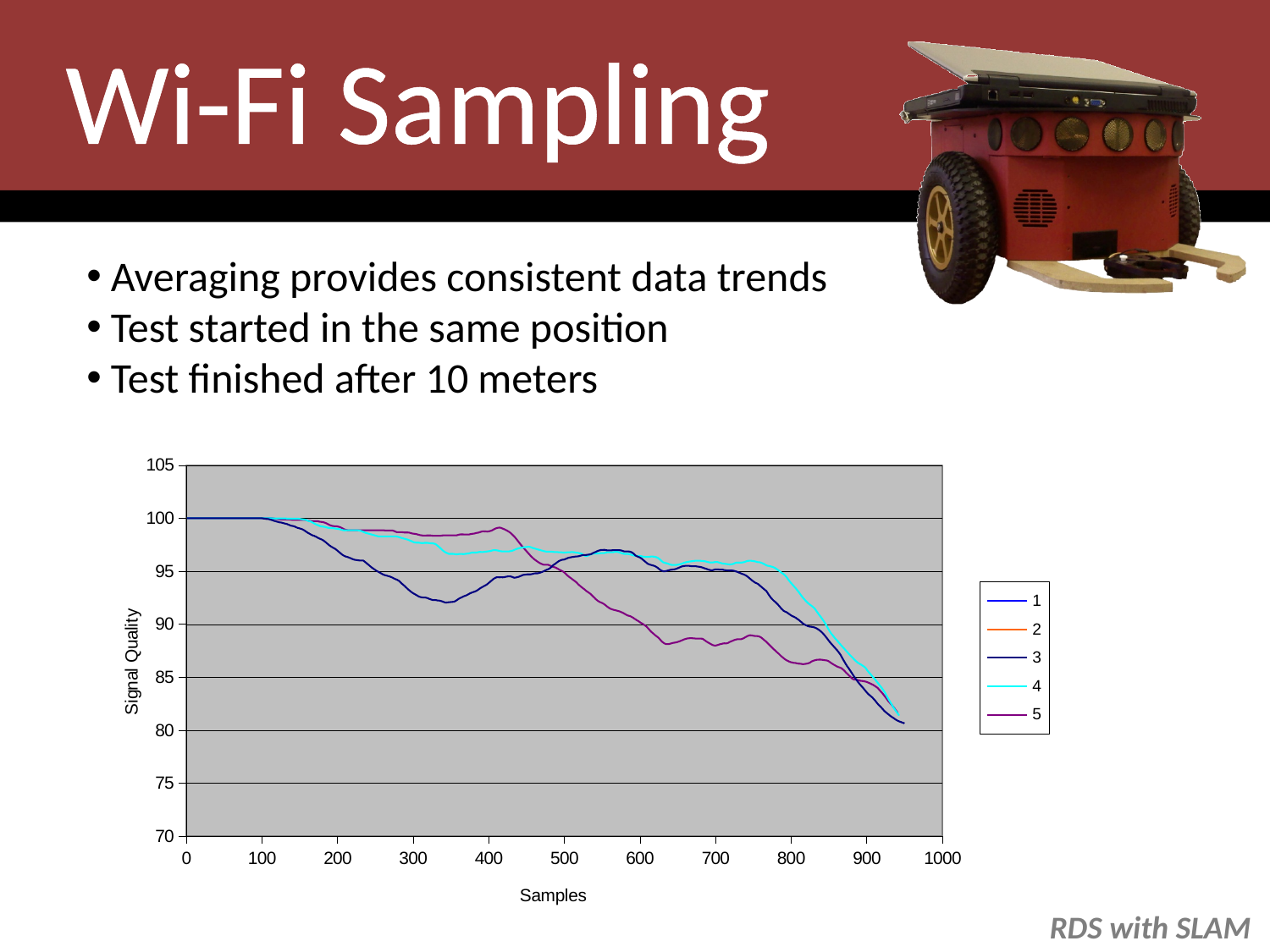
Is the value for series 3 at sample 350 greater or less than 95? less Is the value for series 4 at sample 500 greater or less than 95? greater What kind of chart is shown on the slide? line chart At sample 300, which series has the higher value, series 3 or series 4? series 4 At sample 700, which series has the lowest value? series 5 How many series does the legend list? 5 What is the label of the y axis? Signal Quality Is the value for series 5 at sample 650 greater or less than 90? less What is the label of the x axis? Samples Do the signal quality values generally rise or fall as the number of samples increases? fall What is the signal quality value of series 1 at sample 0? 100